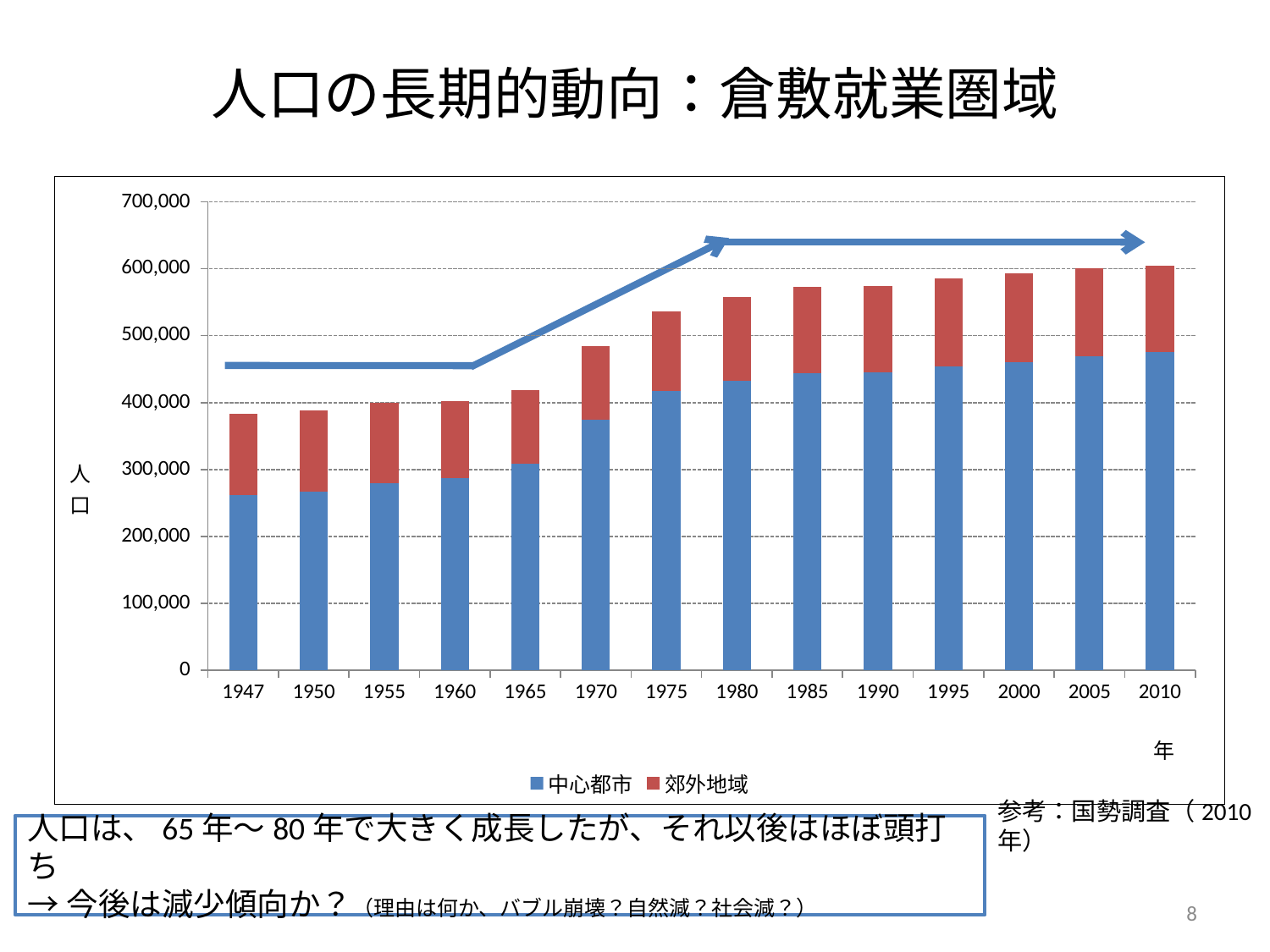
How many years are shown on the x axis of the chart? 14 Do the total population bars rise or fall from 1947 to 2010? rise Which year has the highest total population bar? 2010 Which year has the lowest total population bar? 1947 Which series is shown in red in the chart? 郊外地域 Is the 中心都市 value for 2010 greater or less than 400,000? greater Is the total population for 1947 greater or less than 400,000? less Is the 中心都市 value for 1947 greater or less than 300,000? less Which year has the larger total population bar, 1960 or 1980? 1980 How many series does the chart legend list? 2 What kind of chart is shown on the slide? stacked bar chart